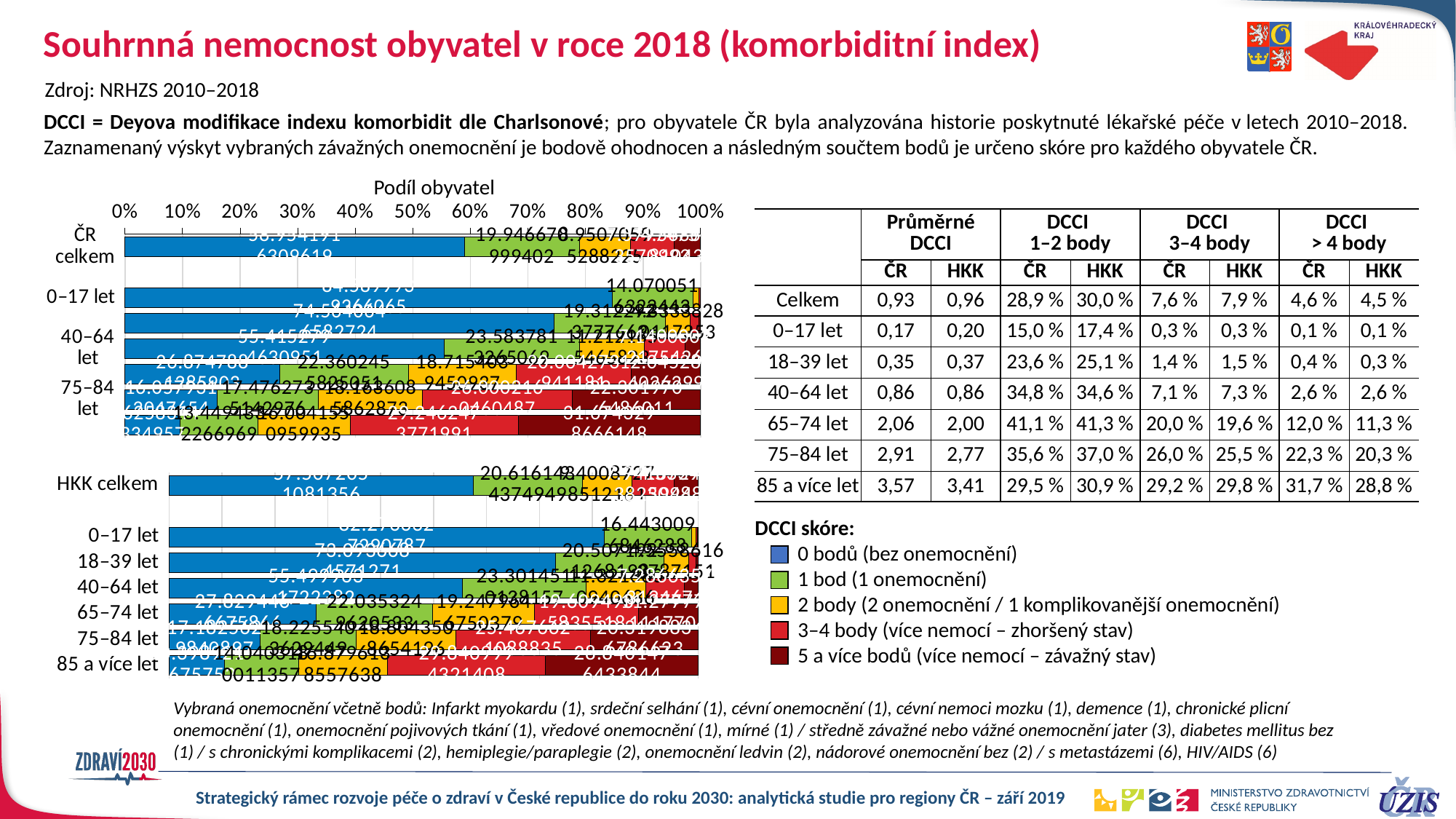
What is the title of the horizontal axis above the upper chart? Podíl obyvatel In the lower chart (HKK), does the share of '0 bodů' rise or fall as the age groups get older? fall What kind of chart is used to show the DCCI score distribution for ČR and HKK? bar chart In the lower chart (HKK), is the share of '0 bodů' for 85 a více let greater or less than 20%? less Which colour represents '0 bodů (bez onemocnění)' in the charts? blue In the lower chart (HKK), is the '0 bodů' share larger for 18–39 let or for 75–84 let? 18–39 let In the upper chart (ČR), is the share of '0 bodů' for ČR celkem greater or less than 50%? greater In the lower chart (HKK), how many categories (rows) are plotted? 7 How many DCCI score categories does the legend (DCCI skóre) list? 5 In the lower chart (HKK), is the share of '0 bodů' for 0–17 let greater or less than 70%? greater In the lower chart (HKK), which category has the smallest share of '0 bodů (bez onemocnění)'? 85 a více let In the lower chart (HKK), which category has the largest share of '0 bodů (bez onemocnění)'? 0–17 let